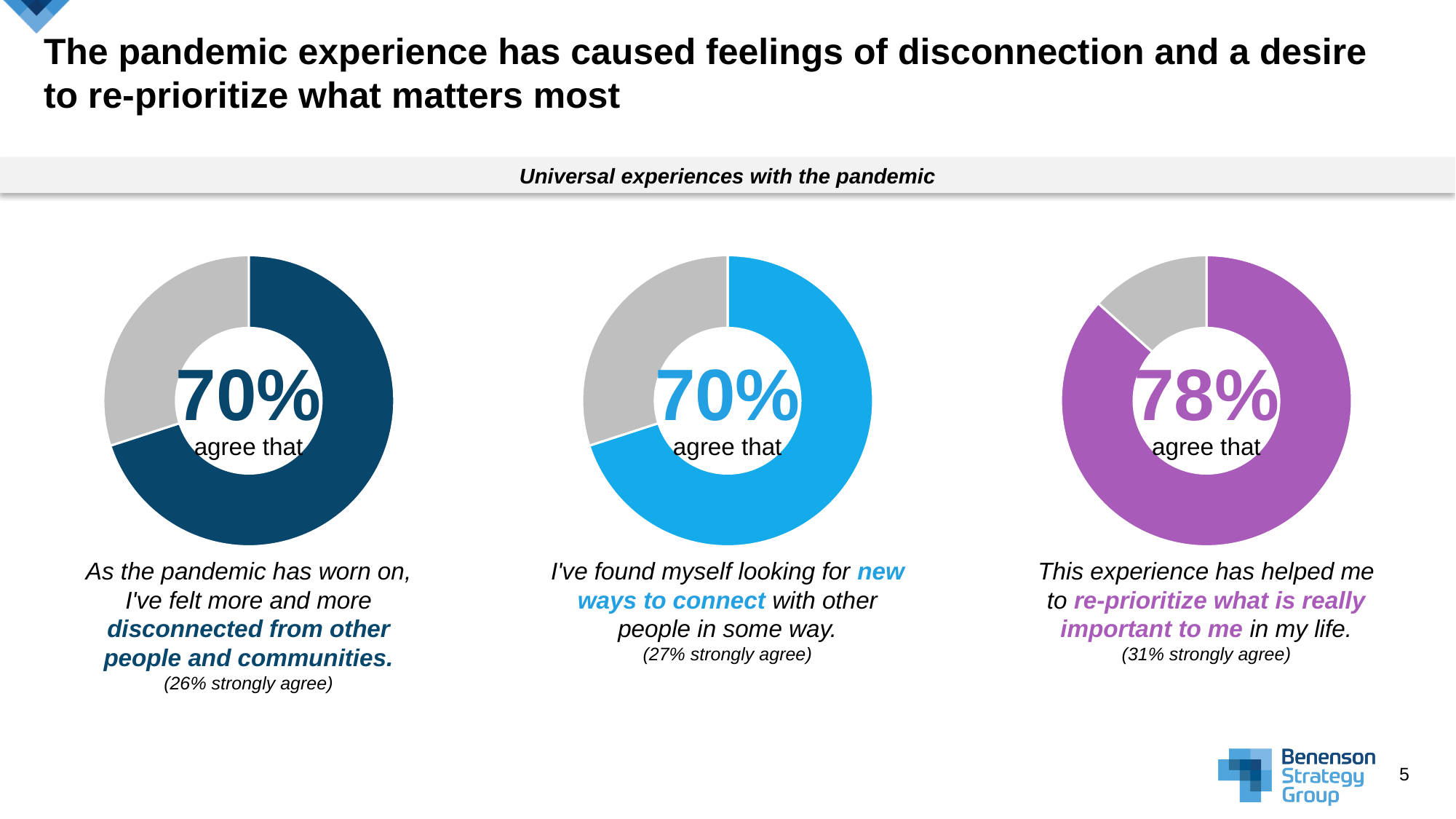
In the left chart, what share of the donut is the grey (non-agree) portion? 30% Which of the three donut charts shows the highest percentage of agreement? The right chart (re-prioritize what is really important), 78% What kind of chart is used on this slide to show the share of people who agree with each statement? Pie (donut) chart Is the agreement percentage in the right chart (78%) larger or smaller than in the left chart (70%)? Larger In the right chart, what percentage agree that the experience has helped them re-prioritize what is really important in their life? 78% Is the agreement value in the middle chart greater or less than 50%? Greater What colour is the agree portion of the right donut chart? Purple What is the difference in percentage points between the agreement shown in the right chart and the agreement shown in the left chart? 8 percentage points In the left chart, what percentage agree that they have felt more and more disconnected from other people and communities? 70% In the middle chart, what percentage agree that they have found themselves looking for new ways to connect with other people? 70% How many donut charts are shown on the slide? 3